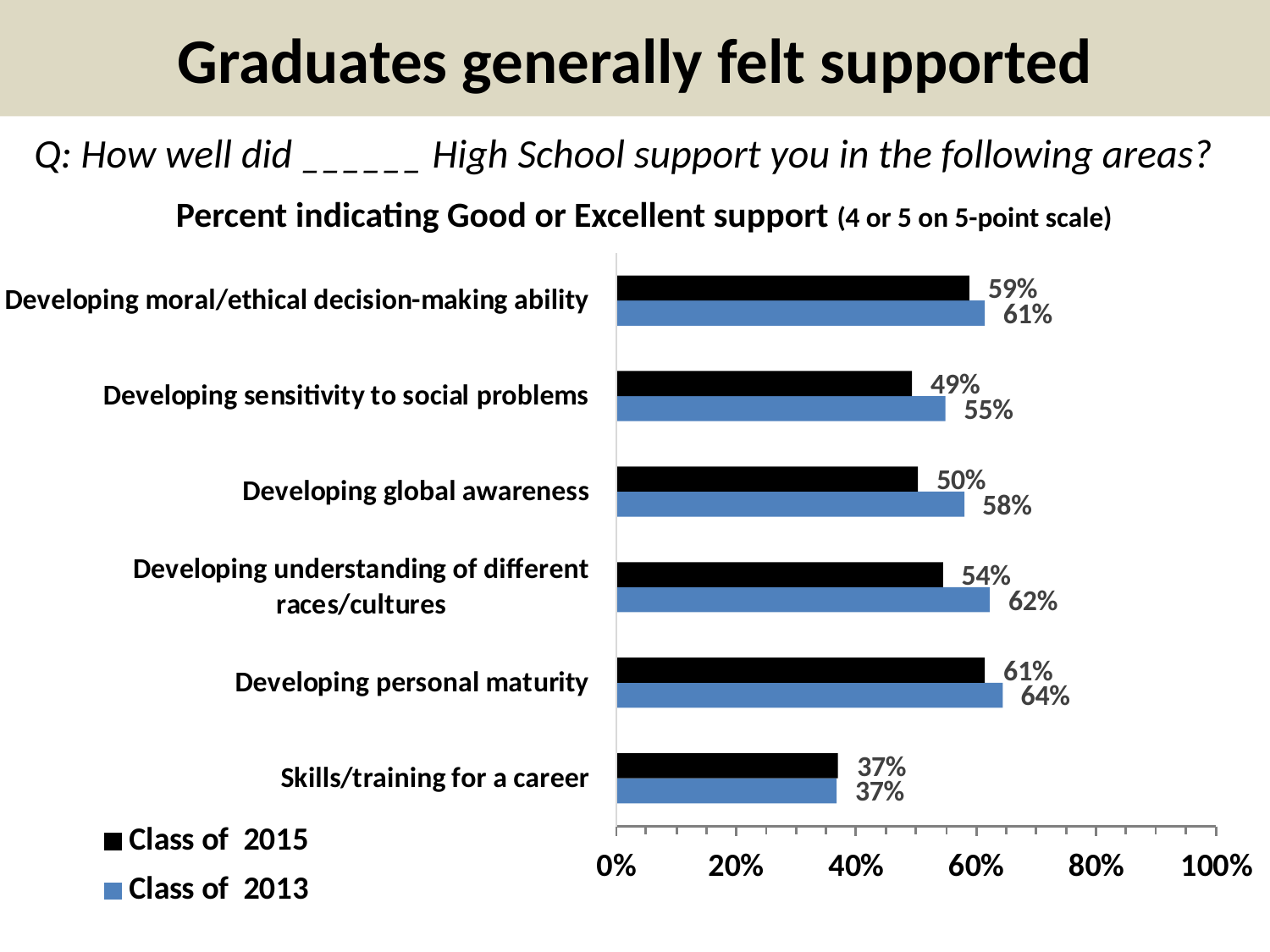
How many series does the legend list? 2 How many categories are shown in the chart? 6 Which colour represents the Class of 2013 in the chart? Blue What percentage of the Class of 2015 indicated Good or Excellent support for Developing moral/ethical decision-making ability? 59% What kind of chart is shown on the slide? Bar chart What is the difference between the Class of 2013 and Class of 2015 values for Developing understanding of different races/cultures? 8% Which category has the highest value for the Class of 2015? Developing personal maturity For Developing global awareness, which class has the larger value, Class of 2015 or Class of 2013? Class of 2013 What is the difference between the Class of 2013 and Class of 2015 values for Developing sensitivity to social problems? 6% Which category has the lowest value for the Class of 2013? Skills/training for a career What is the Class of 2013 value for Developing personal maturity? 64% What percentage of the Class of 2013 indicated Good or Excellent support for Developing global awareness? 58%